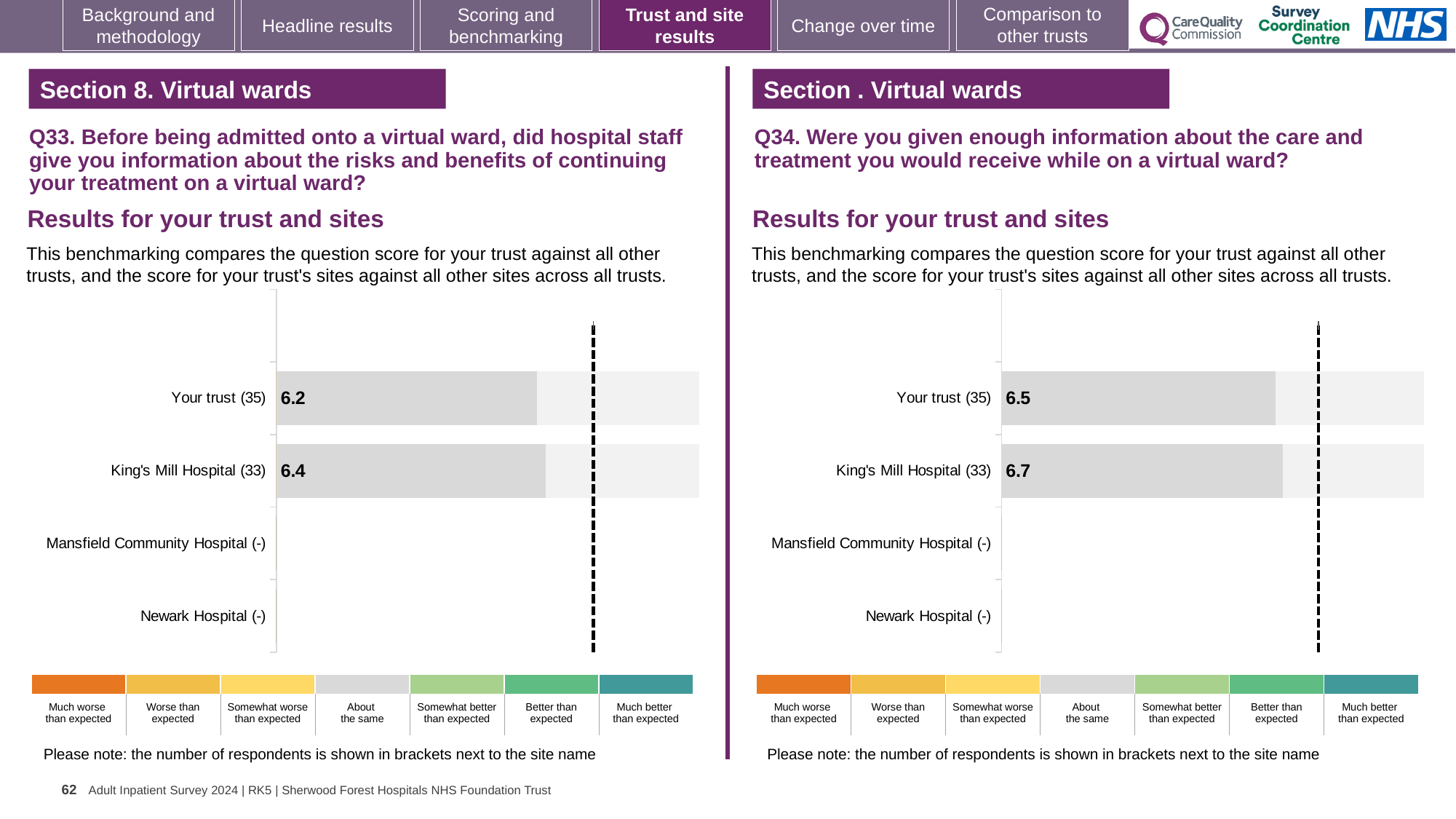
How many categories does the colour key below the Q33 chart on the left list? 7 In the Q34 chart on the right, what is the score for King's Mill Hospital? 6.7 In the Q33 chart on the left, what is the score for King's Mill Hospital? 6.4 How many site/trust categories are listed on the y axis of the Q34 chart on the right? 4 In the Q34 chart on the right, what is the score for Your trust? 6.5 In the Q33 chart on the left, which is higher: Your trust or King's Mill Hospital? King's Mill Hospital What type of chart is used in the Q33 chart on the left? Bar chart In the Q33 chart on the left, what is the difference between the King's Mill Hospital score and the Your trust score? 0.2 In the Q33 chart on the left, what is the score for Your trust? 6.2 In the Q34 chart on the right, which category has the highest score among those with a plotted bar? King's Mill Hospital In the Q34 chart on the right, what is the difference between the King's Mill Hospital score and the Your trust score? 0.2 In the Q33 chart on the left, how many respondents are shown in brackets for King's Mill Hospital? 33